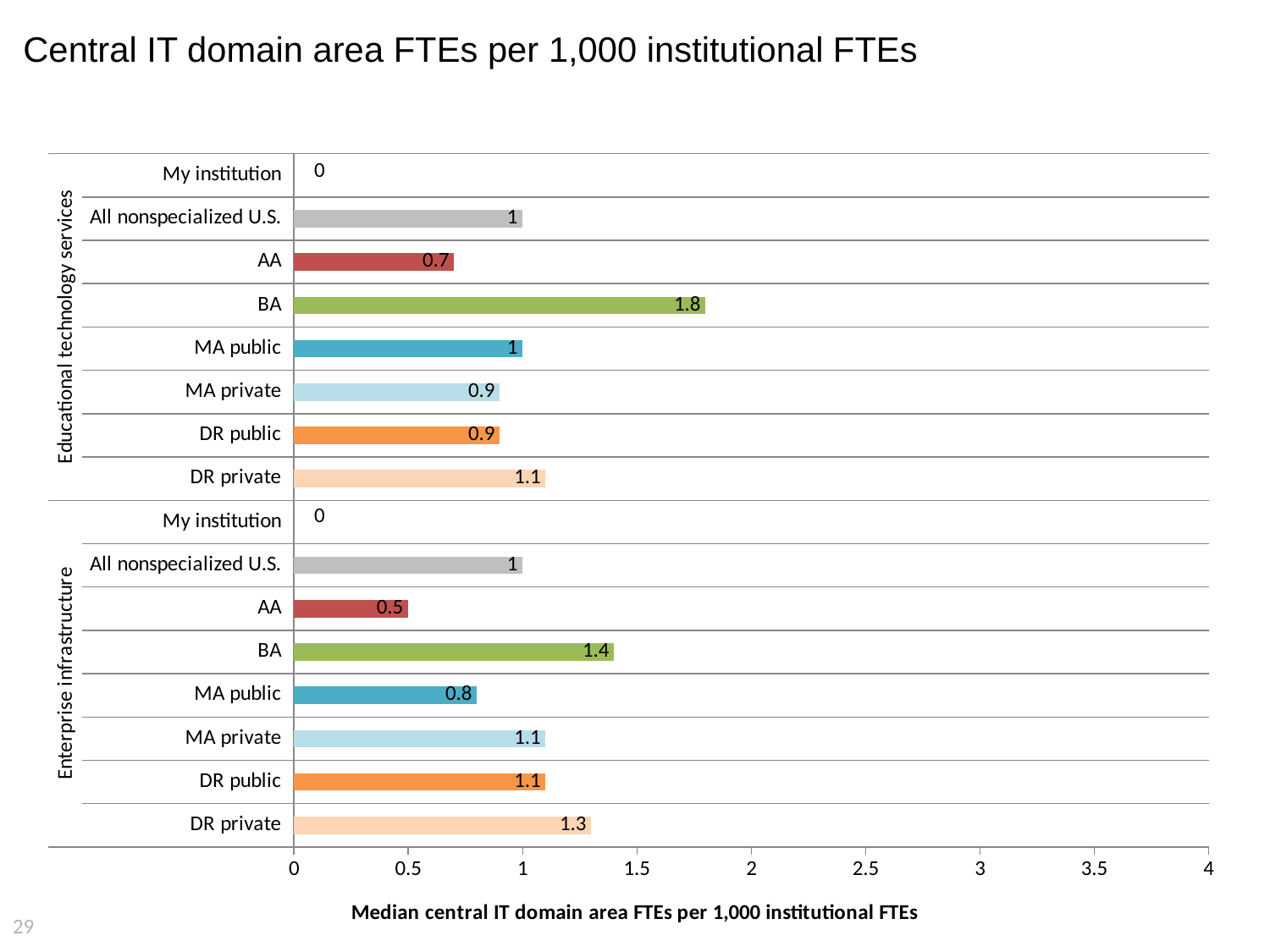
Is the value for BA under Educational technology services greater or less than 1.5? greater What is the value for BA under Educational technology services? 1.8 What is the value for DR private under Enterprise infrastructure? 1.3 Which is larger under Enterprise infrastructure: MA public or MA private? MA private What is the value for My institution under Educational technology services? 0 What is the difference between the BA values for Educational technology services and Enterprise infrastructure? 0.4 How many categories are plotted under Enterprise infrastructure? 8 What is the x-axis title of the chart? Median central IT domain area FTEs per 1,000 institutional FTEs Excluding My institution, which category has the lowest value under Enterprise infrastructure? AA What is the value for AA under Enterprise infrastructure? 0.5 Which category has the highest value under Educational technology services? BA What kind of chart is shown on the slide? Bar chart